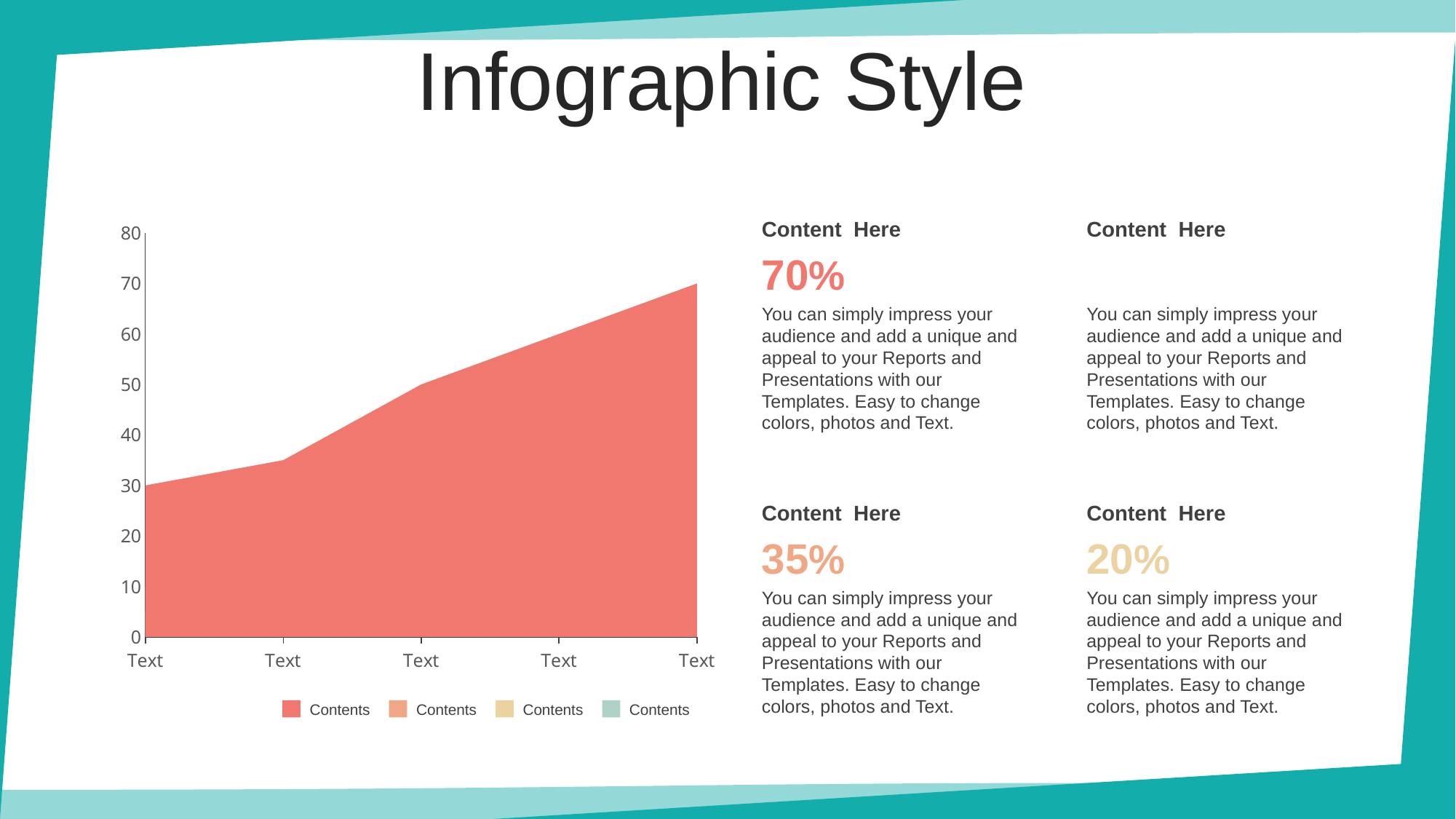
Which point in the chart has the lowest value? the first (leftmost) point How many series does the chart's legend list? 4 Is the value of the middle (third) point in the chart greater or less than 40? greater Is the value of the last (rightmost) point in the chart greater or less than 60? greater How many points are plotted along the x axis of the chart? 5 What is the highest value shown on the chart's y axis? 80 Do the values in the chart rise or fall from left to right along the x axis? rise What kind of chart is shown on the slide? area chart Is the value of the second point in the chart greater or less than 50? less Which is larger in the chart, the value of the fourth point or the value of the second point? the fourth point Which point in the chart has the highest value? the last (rightmost) point